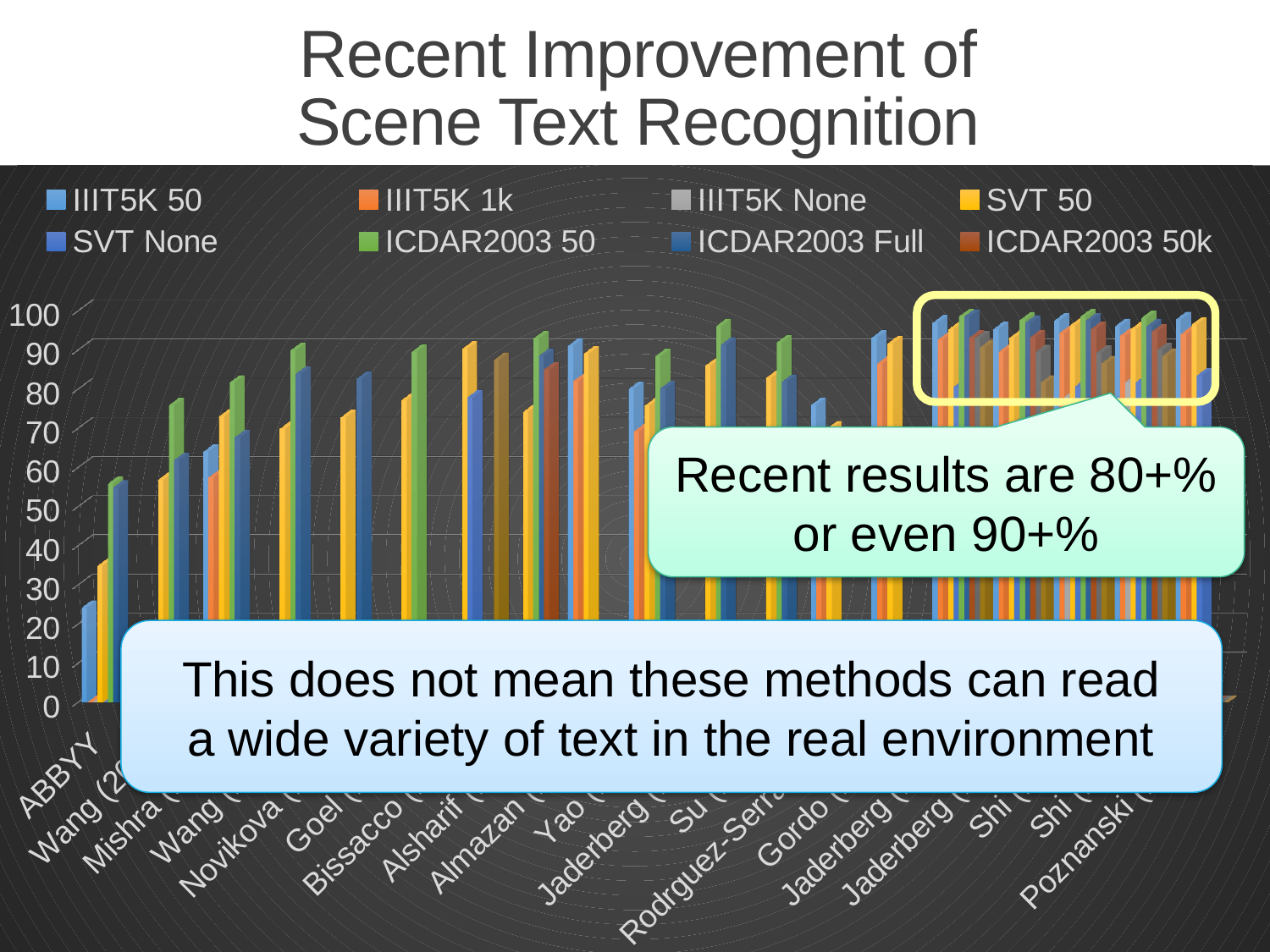
What is the highest value shown on the vertical axis? 100 Is the IIIT5K 50 value for Poznanski greater or less than 90? greater What kind of chart is shown on the slide? bar chart How many method categories are plotted along the x axis? 19 Do the recognition accuracy values generally rise or fall from left to right along the x axis? rise Is the ICDAR2003 50 value for Goel greater or less than 80? greater Is the IIIT5K 50 value for ABBYY greater or less than 40? less Which colour represents the ICDAR2003 50 series in the legend? green What is the title of the slide containing the chart? Recent Improvement of Scene Text Recognition Which has the larger IIIT5K 50 value, ABBYY or Poznanski? Poznanski How many series does the legend list? 8